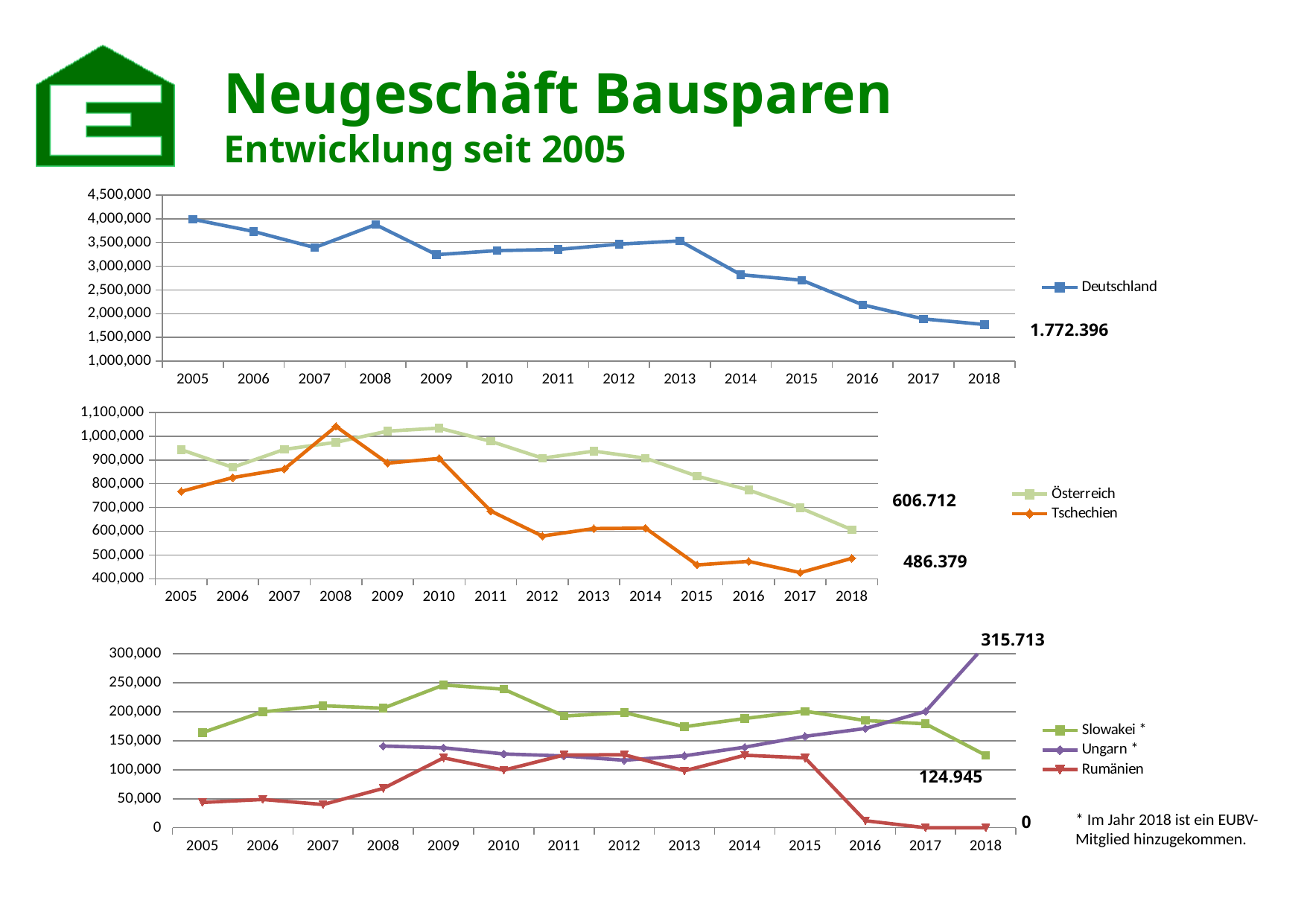
How many series does the legend of the middle chart list? 2 In the bottom chart, what is the value for Ungarn in 2018? 315.713 In the bottom chart, is the value for Slowakei in 2009 greater or less than 200,000? greater In the top chart, is the value for Deutschland in 2005 greater or less than 3,500,000? greater In the middle chart, what is the value for Österreich in 2018? 606.712 In the top chart, what is the value for Deutschland in 2018? 1.772.396 What kind of chart is the top chart showing Deutschland? line chart In the top chart, do the values for Deutschland rise or fall from 2013 to 2018? fall In the middle chart, what is the value for Tschechien in 2018? 486.379 In the middle chart, what is the difference between the 2018 values for Österreich and Tschechien? 120.333 How many years are plotted on the x axis of the top chart? 14 In the bottom chart, which series has the highest value in 2018? Ungarn *